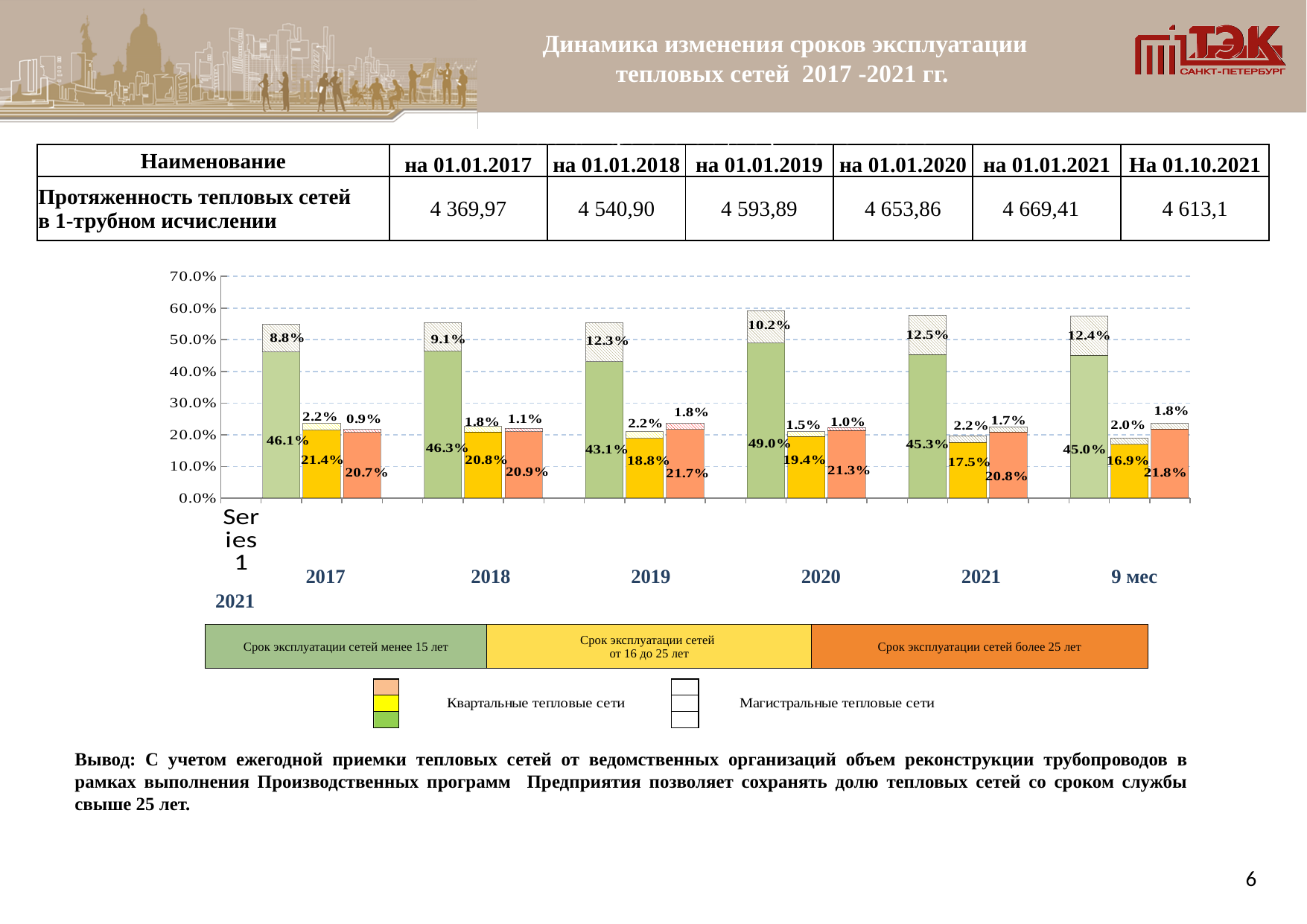
What is the share of quarter heat networks with a service life of 16 to 25 years for 9 months of 2021? 16.9% Which is larger: the share of main heat networks with a service life of less than 15 years in 2019 or in 2017? 2019 In which year is the share of quarter heat networks with a service life of less than 15 years the lowest? 2019 How many year categories are shown along the x axis of the chart? 6 What is the share of main heat networks (Магистральные тепловые сети) with a service life of more than 25 years in 2019? 1.8% How many service-life groups does the coloured legend below the chart list? 3 What is the share of quarter heat networks (Квартальные тепловые сети) with a service life of less than 15 years in 2017? 46.1% Is the total stacked bar for networks with a service life of less than 15 years in 2020 greater or less than 50.0%? greater What is the difference between the share of quarter heat networks with a service life of more than 25 years in 2019 and in 2017? 1.0% What is the total height of the stacked bar for networks with a service life of less than 15 years in 2020 (quarter plus main networks)? 59.2% What type of chart is shown on the slide? bar chart In which year is the share of quarter heat networks with a service life of less than 15 years the highest? 2020